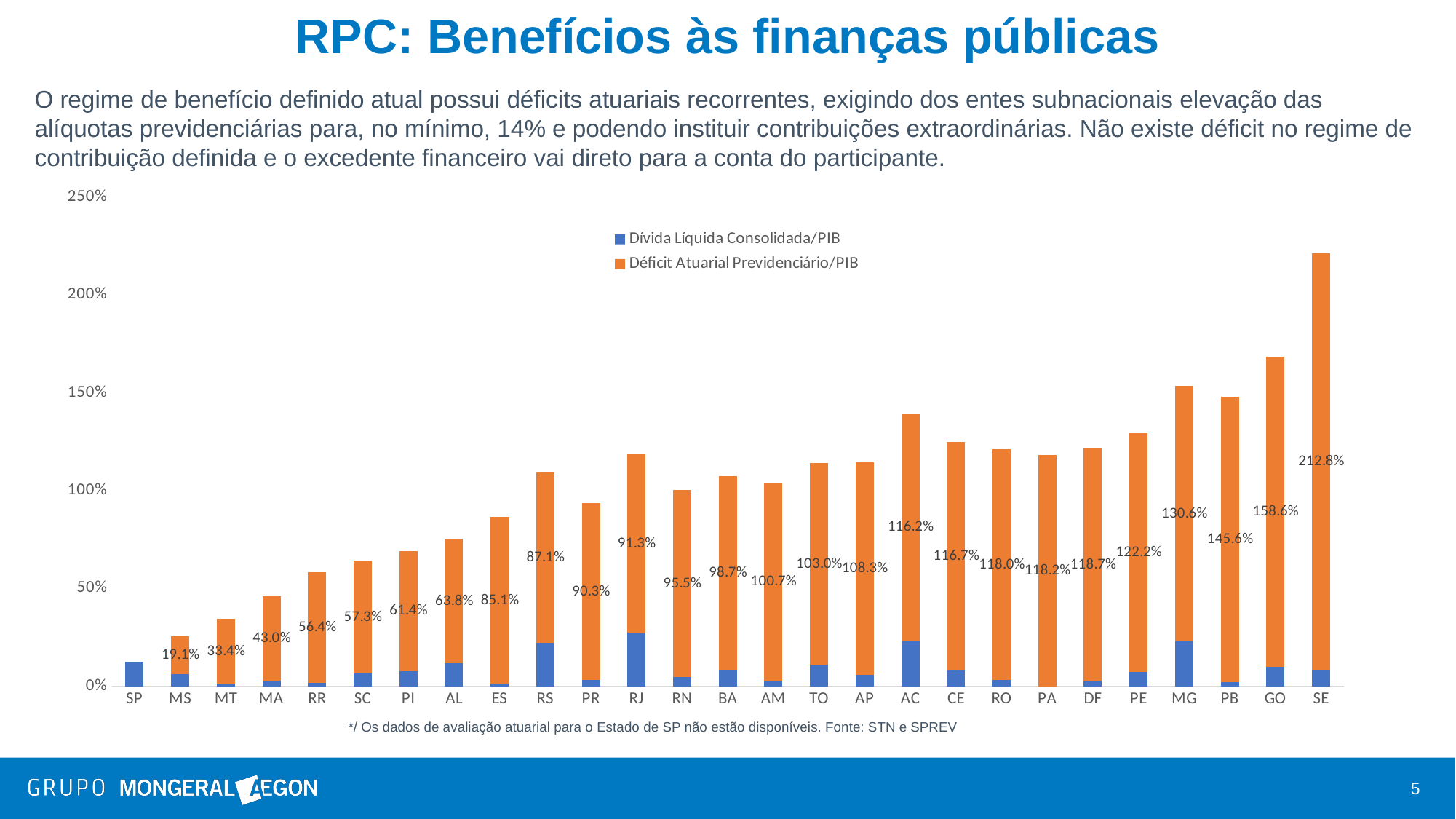
How many states are shown on the x axis? 27 What is the difference between the Déficit Atuarial Previdenciário/PIB values for GO and PB? 13.0 percentage points What is the Déficit Atuarial Previdenciário/PIB value for MG? 130.6% What is the Déficit Atuarial Previdenciário/PIB value for SE? 212.8% How many series does the legend list? 2 Among the states with a labelled Déficit Atuarial Previdenciário/PIB value, which has the lowest? MS What kind of chart is shown on the slide? Stacked bar chart Which has the larger Déficit Atuarial Previdenciário/PIB value, BA or RN? BA Is the total stacked bar for RS greater or less than 100%? greater What is the Déficit Atuarial Previdenciário/PIB value for MS? 19.1% Is the total stacked bar for SE greater or less than 200%? greater Which state has the highest Déficit Atuarial Previdenciário/PIB value? SE